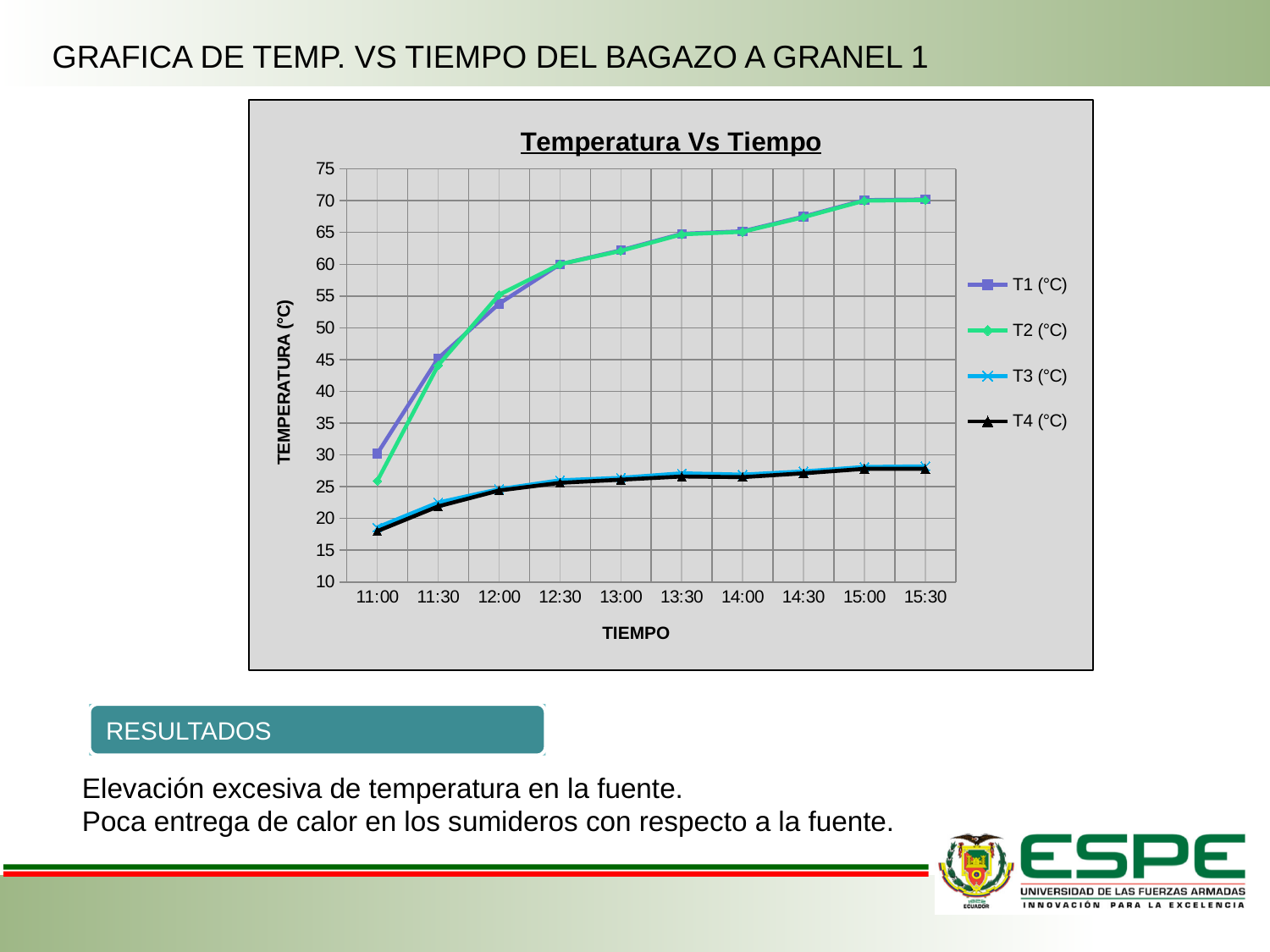
Is the value for T1 (°C) at 15:30 greater or less than 65? greater Is the value for T1 (°C) at 11:00 greater or less than 35? less What type of chart is shown on the slide? line chart Is the value for T3 (°C) at 15:30 greater or less than 25? greater At 13:00, which is larger, T1 (°C) or T4 (°C)? T1 (°C) How many time points are shown on the x axis? 10 At 11:00, which series has the highest temperature? T1 (°C) What is the title of the chart? Temperatura Vs Tiempo Do the T1 (°C) values rise or fall from 11:00 to 15:30? rise How many series does the legend list? 4